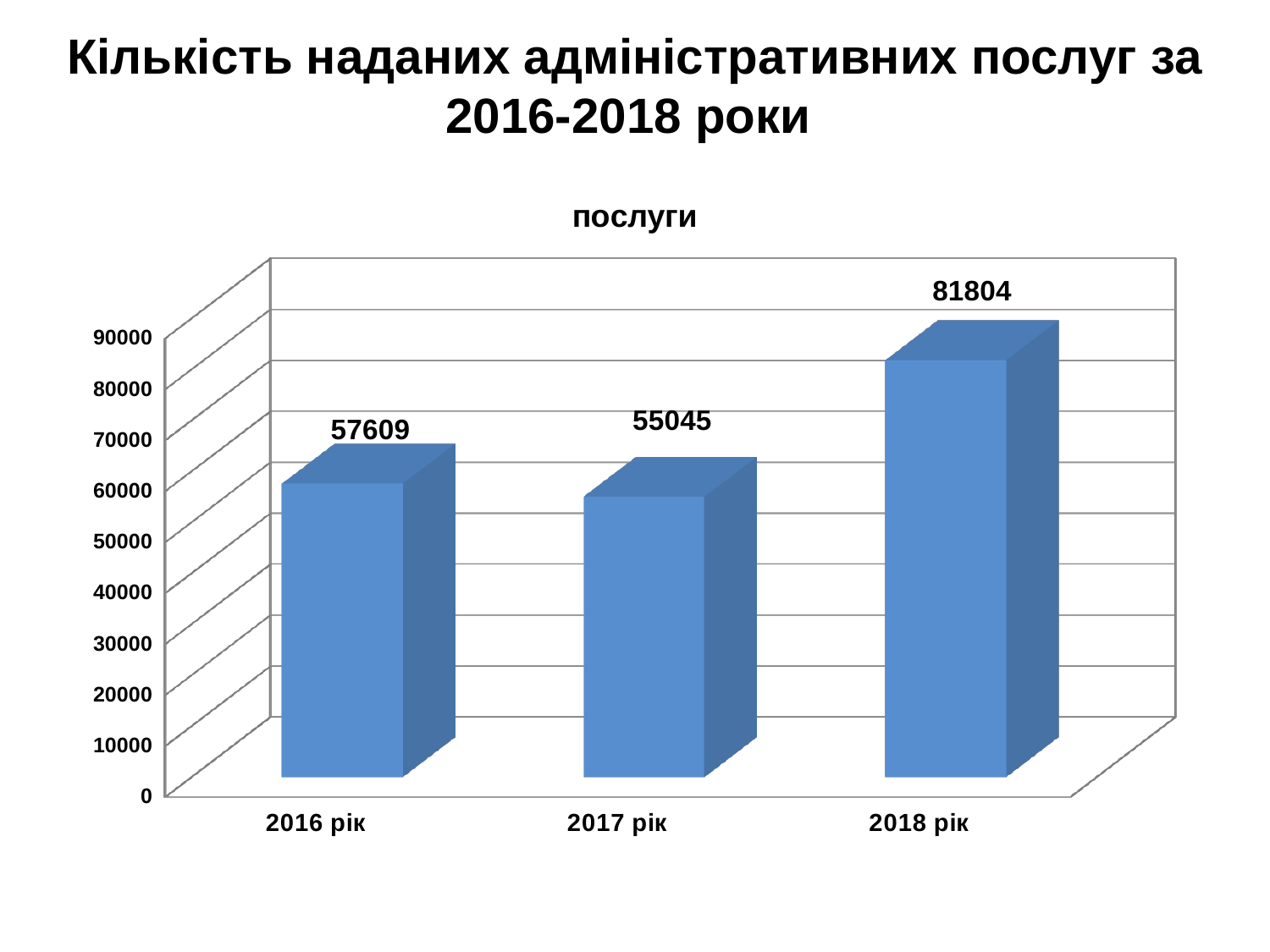
Is the value for 2018 рік greater or less than 70000? greater Which year has the highest value? 2018 рік What is the title of the chart? послуги Which is larger, the value for 2016 рік or the value for 2018 рік? 2018 рік What is the value for 2017 рік? 55045 How many categories are shown on the x axis? 3 What is the difference between the values for 2018 рік and 2017 рік? 26759 What is the difference between the values for 2016 рік and 2017 рік? 2564 Which year has the lowest value? 2017 рік What is the value for 2018 рік? 81804 What is the value for 2016 рік? 57609 What kind of chart is shown on the slide? bar chart